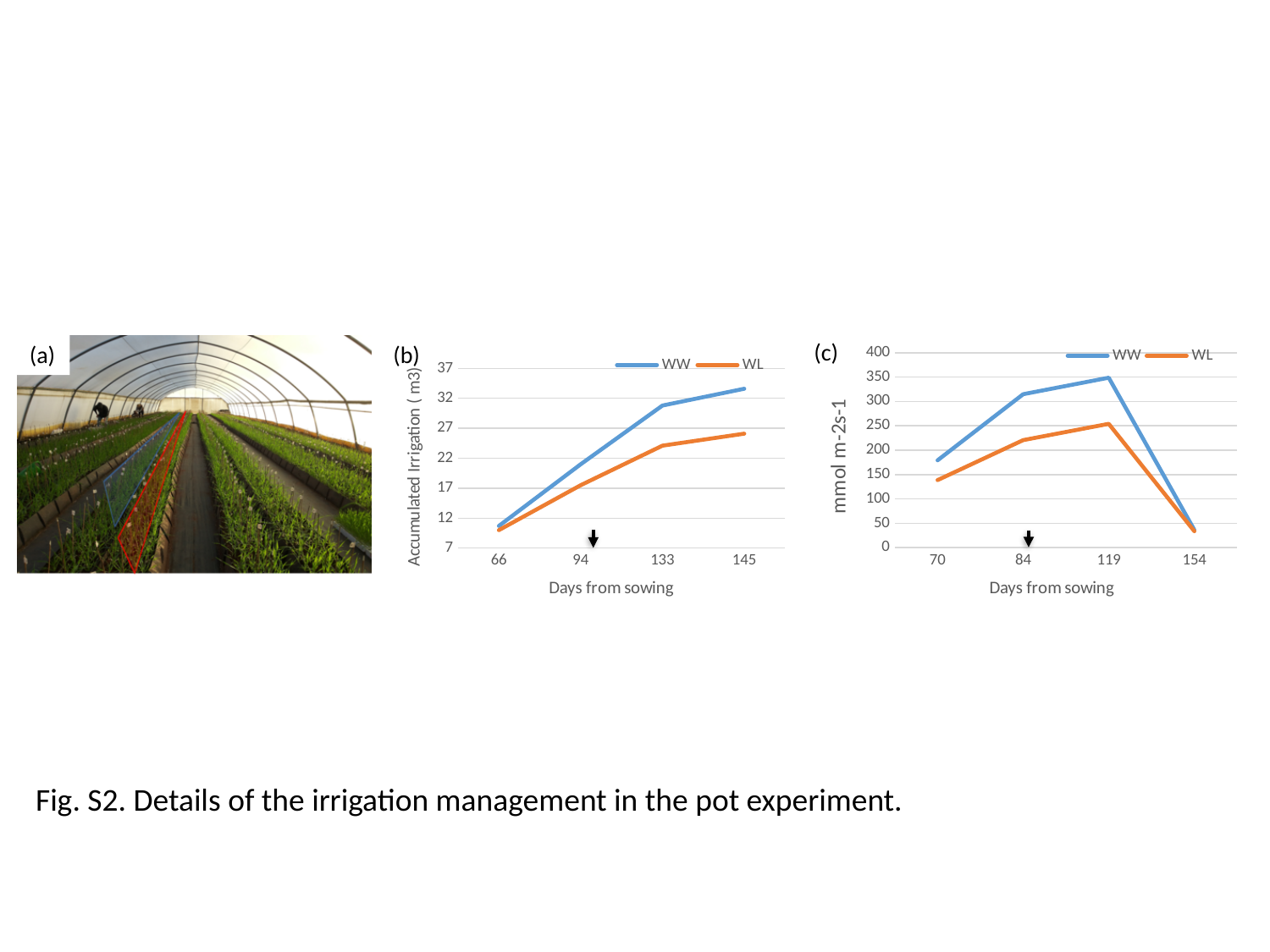
How many series does the legend list in chart (c)? 2 What kind of chart is chart (b), Accumulated Irrigation? line chart In chart (b), at 145 days from sowing, which series has the larger value, WW or WL? WW What is the x-axis label of chart (c)? Days from sowing In chart (b), is the WW value at 145 days greater or less than 27? greater How many points along the x axis does chart (b) show? 4 In chart (c), at which day from sowing does the WW line reach its highest value? 119 In chart (b), does the WW line rise or fall from 66 to 145 days from sowing? rise In chart (c), is the WW value at 119 days greater or less than 300? greater In chart (b), is the WL value at 66 days greater or less than 12? less In chart (c), at 119 days from sowing, which series has the larger value, WW or WL? WW